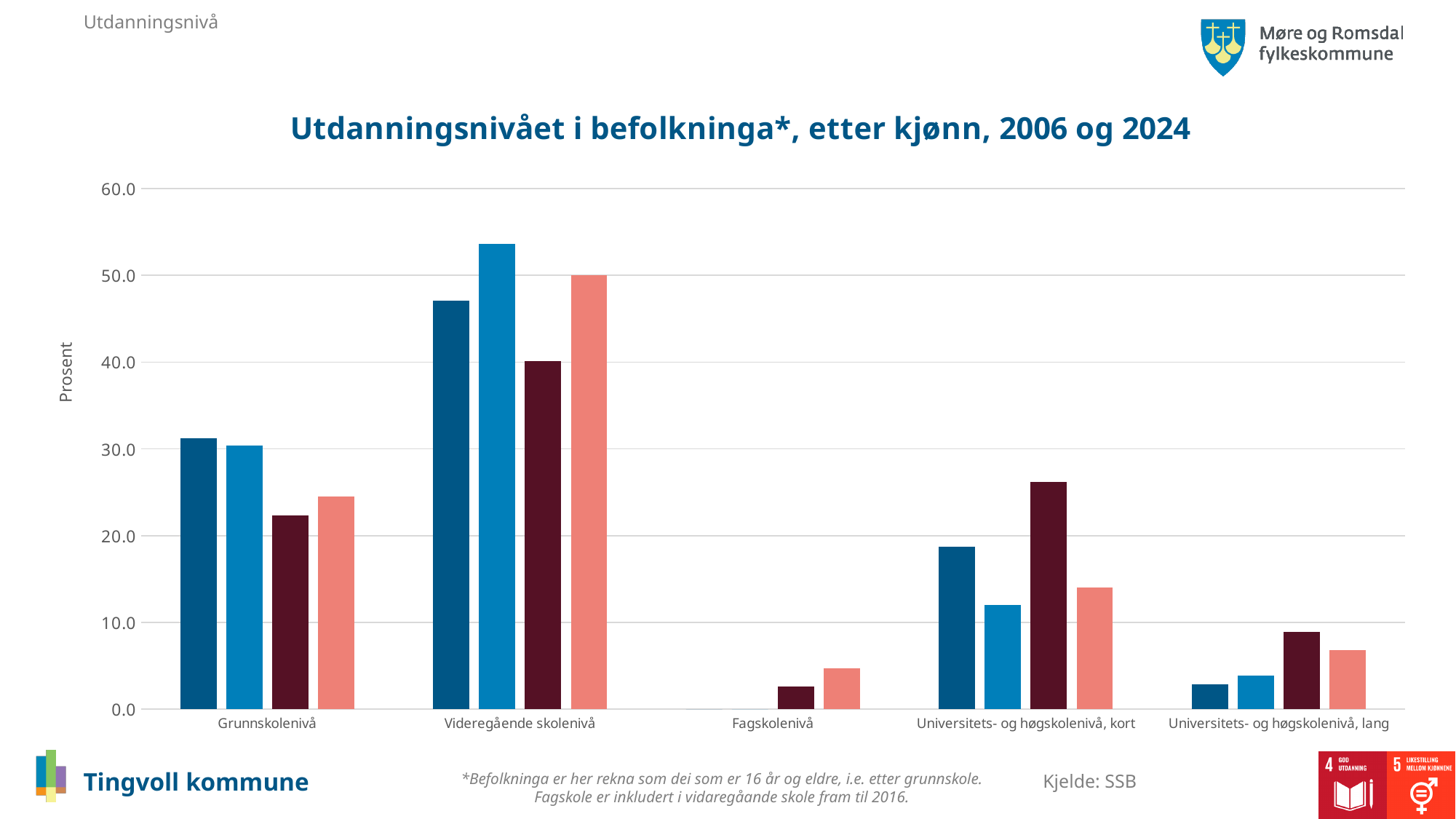
For Grunnskolenivå, which is larger: the dark blue bar or the dark maroon bar? the dark blue bar How many categories are shown along the x axis of the chart? 5 What is the title of the chart? Utdanningsnivået i befolkninga*, etter kjønn, 2006 og 2024 Which category has the lowest values in the chart? Fagskolenivå Which category has the tallest bars in the chart? Videregående skolenivå Is the value of the dark maroon bar for Universitets- og høgskolenivå, kort greater or less than 20.0? greater What type of chart is shown on the slide? bar chart Is the value of the light blue bar for Videregående skolenivå greater or less than 50.0? greater How many bars are plotted for each category in the chart? 4 For Universitets- og høgskolenivå, kort, which is larger: the light blue bar or the dark maroon bar? the dark maroon bar Is the value of the salmon-coloured bar for Fagskolenivå greater or less than 10.0? less What is the label on the vertical axis of the chart? Prosent